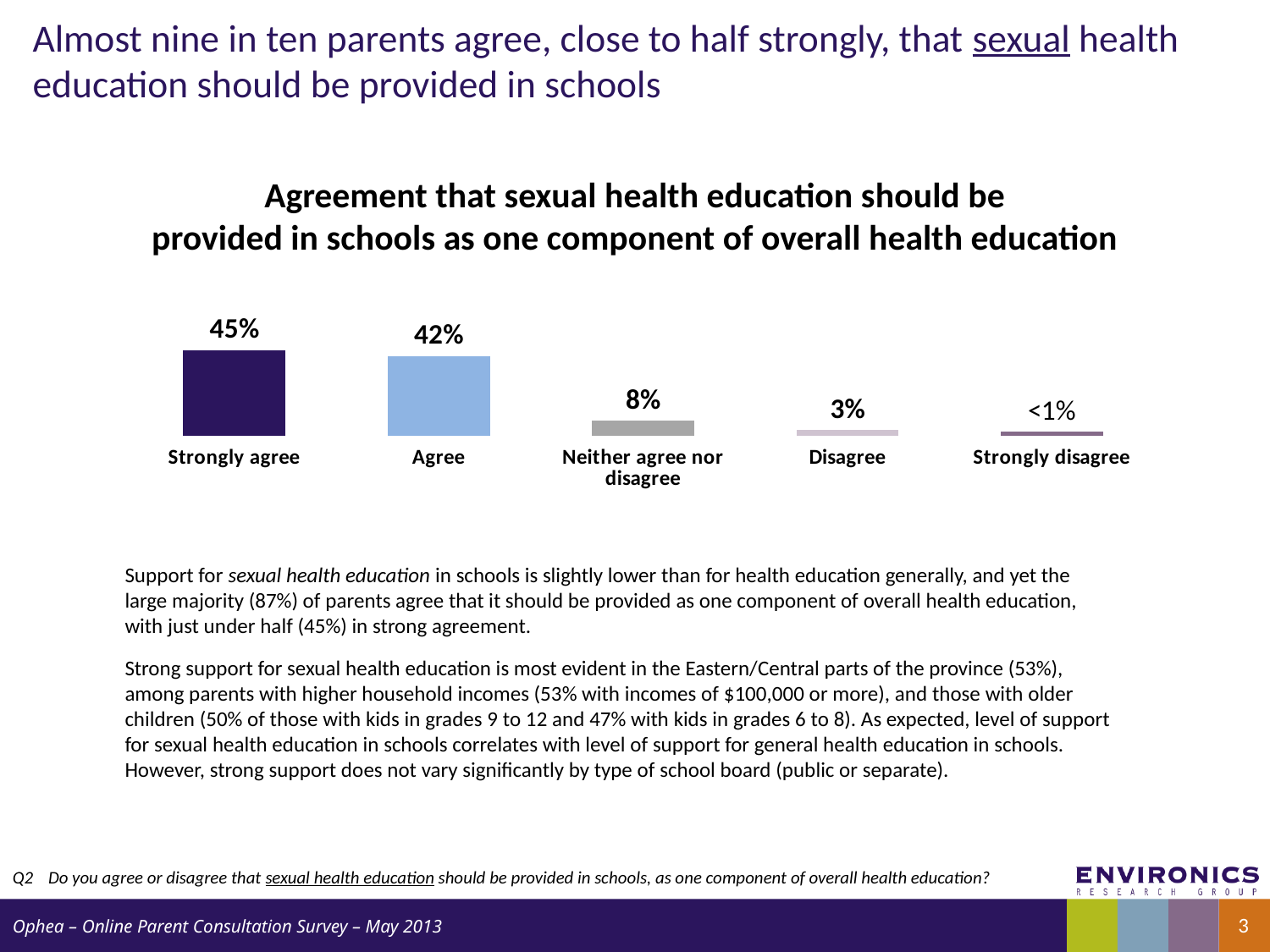
What is the value shown for the Disagree category? 3% What is the value shown for Strongly disagree? <1% What is the value shown for Neither agree nor disagree? 8% What percentage of parents strongly agree that sexual health education should be provided in schools? 45% What is the value shown for the Agree category? 42% What is the difference between the Agree and Neither agree nor disagree values? 34 percentage points What is the difference between the Strongly agree and Agree values? 3 percentage points Which category has the lowest value? Strongly disagree How many categories are shown in the chart? 5 Which is larger, the value for Neither agree nor disagree or the value for Disagree? Neither agree nor disagree Which category has the highest value? Strongly agree What type of chart is shown on the slide? Bar chart